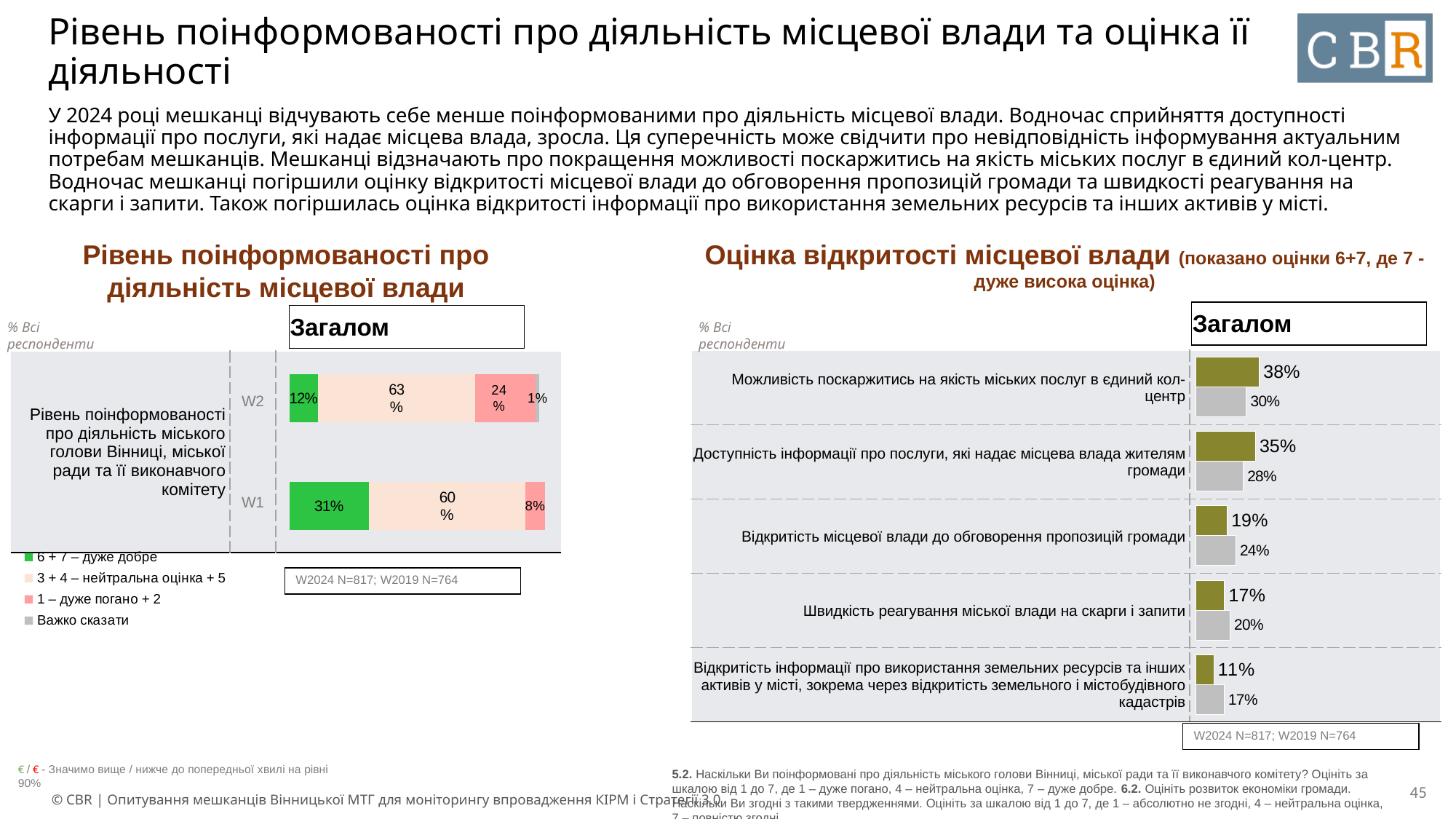
On the left chart 'Рівень поінформованості про діяльність місцевої влади', what is the value of the '1 – дуже погано + 2' segment for W2? 24% On the right chart 'Оцінка відкритості місцевої влади', what is the value of the grey (bottom) bar for 'Відкритість місцевої влади до обговорення пропозицій громади'? 24% On the right chart 'Оцінка відкритості місцевої влади', how many categories are shown? 5 On the right chart 'Оцінка відкритості місцевої влади', which category has the lowest olive (top) bar value? Відкритість інформації про використання земельних ресурсів та інших активів у місті, зокрема через відкритість земельного і містобудівного кадастрів On the right chart 'Оцінка відкритості місцевої влади', what is the value of the olive (top) bar for 'Можливість поскаржитись на якість міських послуг в єдиний кол-центр'? 38% On the right chart 'Оцінка відкритості місцевої влади', which category has the highest olive (top) bar value? Можливість поскаржитись на якість міських послуг в єдиний кол-центр On the right chart 'Оцінка відкритості місцевої влади', what is the difference between the olive (top) and grey (bottom) bars for 'Доступність інформації про послуги, які надає місцева влада жителям громади'? 7% On the left chart 'Рівень поінформованості про діяльність місцевої влади', what is the value of the '6 + 7 – дуже добре' segment for W2? 12% What kind of chart is the left chart 'Рівень поінформованості про діяльність місцевої влади'? Stacked bar chart On the left chart 'Рівень поінформованості про діяльність місцевої влади', what is the difference between the '3 + 4 – нейтральна оцінка + 5' values for W2 and W1? 3% On the left chart 'Рівень поінформованості про діяльність місцевої влади', how many entries does the legend list? 4 On the left chart 'Рівень поінформованості про діяльність місцевої влади', what is the value of the '6 + 7 – дуже добре' segment for W1? 31%